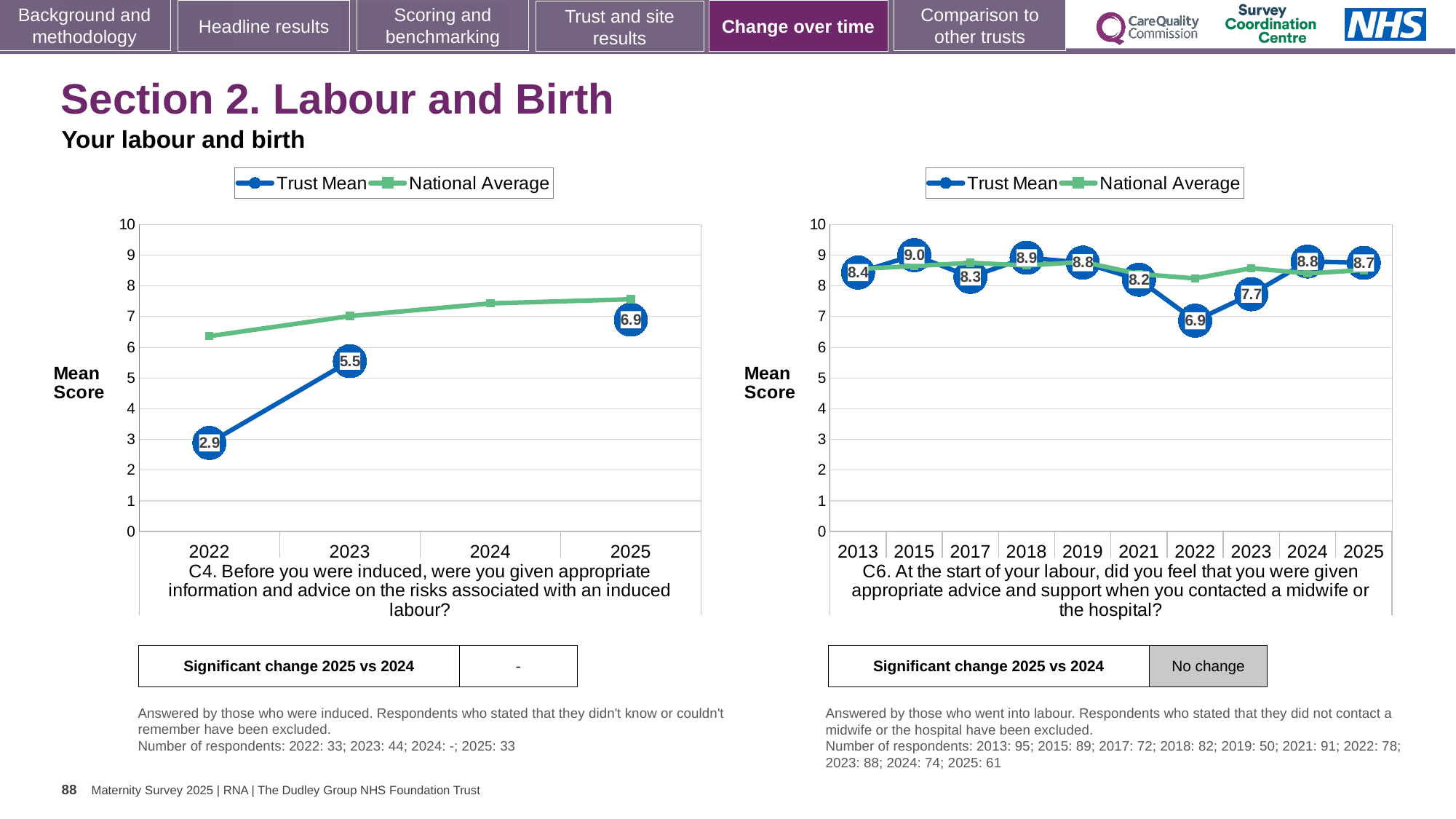
In the left chart (C4), what is the Trust Mean score for 2022? 2.9 In the right chart (C6), which year has the highest Trust Mean score? 2015 In the right chart (C6), what is the Trust Mean score for 2022? 6.9 In the right chart (C6), which year has the lowest Trust Mean score? 2022 In the right chart (C6), how many years are shown on the x axis? 10 In the right chart (C6), how many series does the legend list? 2 In the left chart (C4), is the National Average for 2022 greater or less than 6? greater In the left chart (C4), what is the Trust Mean score for 2025? 6.9 In the left chart (C4), does the Trust Mean rise or fall from 2022 to 2025? rise In the right chart (C6), what is the difference between the Trust Mean scores for 2024 and 2023? 1.1 In the left chart (C4), what is the difference between the Trust Mean scores for 2023 and 2022? 2.6 What type of chart is the left chart (C4)? line chart